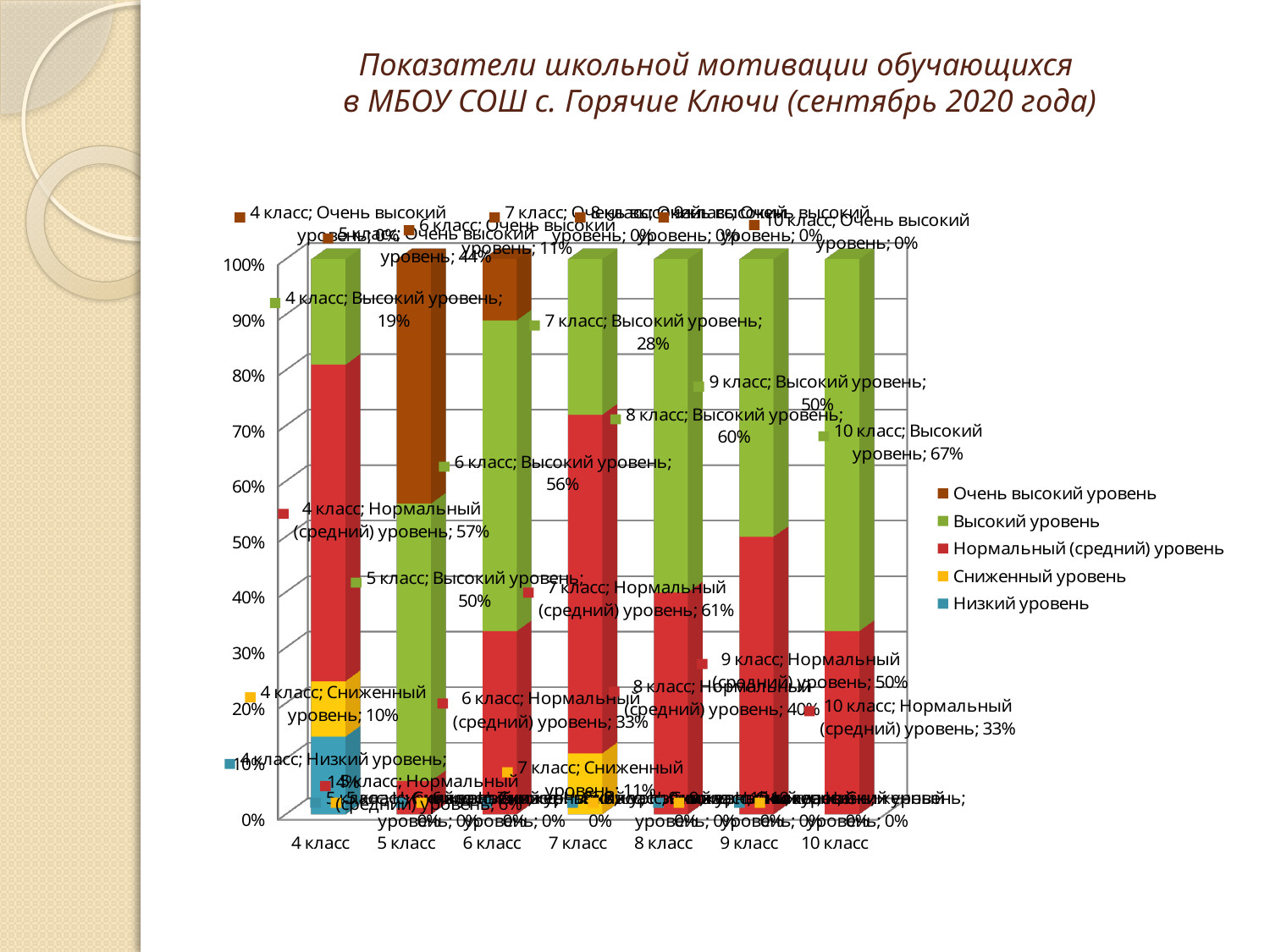
Which class has the highest value for 'Высокий уровень'? 10 класс Which class has the lowest value for 'Высокий уровень'? 4 класс What is the value for 'Очень высокий уровень' in 5 класс? 44% How many classes are shown on the x axis? 7 Which series is shown in yellow in the legend? Сниженный уровень What is the value for 'Низкий уровень' in 4 класс? 14% Which is larger: 'Нормальный (средний) уровень' in 7 класс or in 8 класс? 7 класс What is the difference between the 'Высокий уровень' values for 10 класс and 4 класс? 48 percentage points What is the value for 'Высокий уровень' in 10 класс? 67% What is the value for 'Нормальный (средний) уровень' in 7 класс? 61% What kind of chart is shown on the slide? Stacked bar chart How many series does the legend list? 5